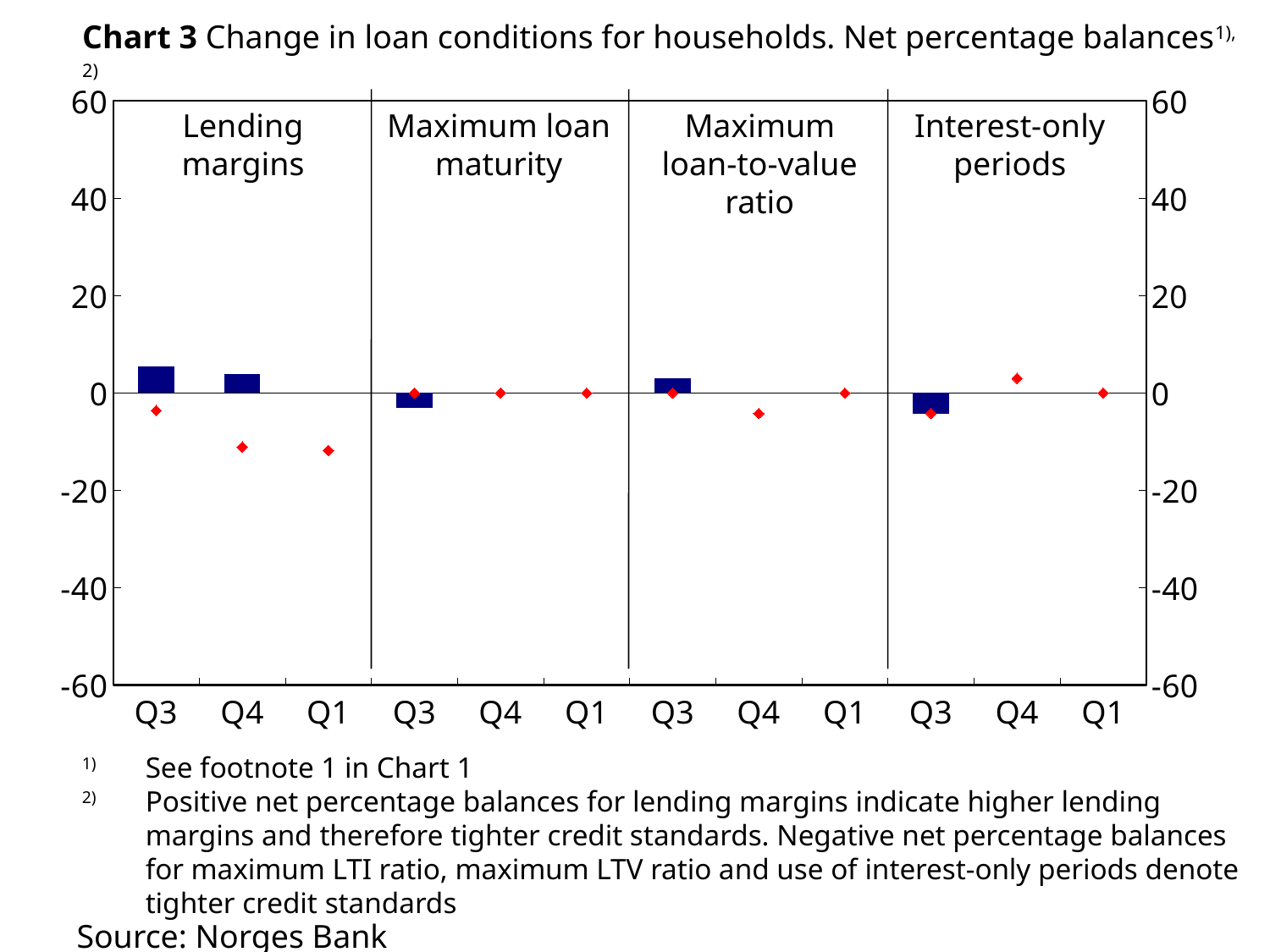
How many panels (loan condition categories) does Chart 3 show? 4 How many quarters are shown on the x axis within each panel of Chart 3? 3 Is the bar for Q3 in the Lending margins panel greater or less than 0? greater Is the red diamond for Q4 in the Interest-only periods panel greater or less than 0? greater Is the red diamond for Q4 in the Lending margins panel greater or less than -20? greater What is the source given for Chart 3? Norges Bank What kind of chart is Chart 3? bar chart What is the title of the panel furthest to the right in Chart 3? Interest-only periods